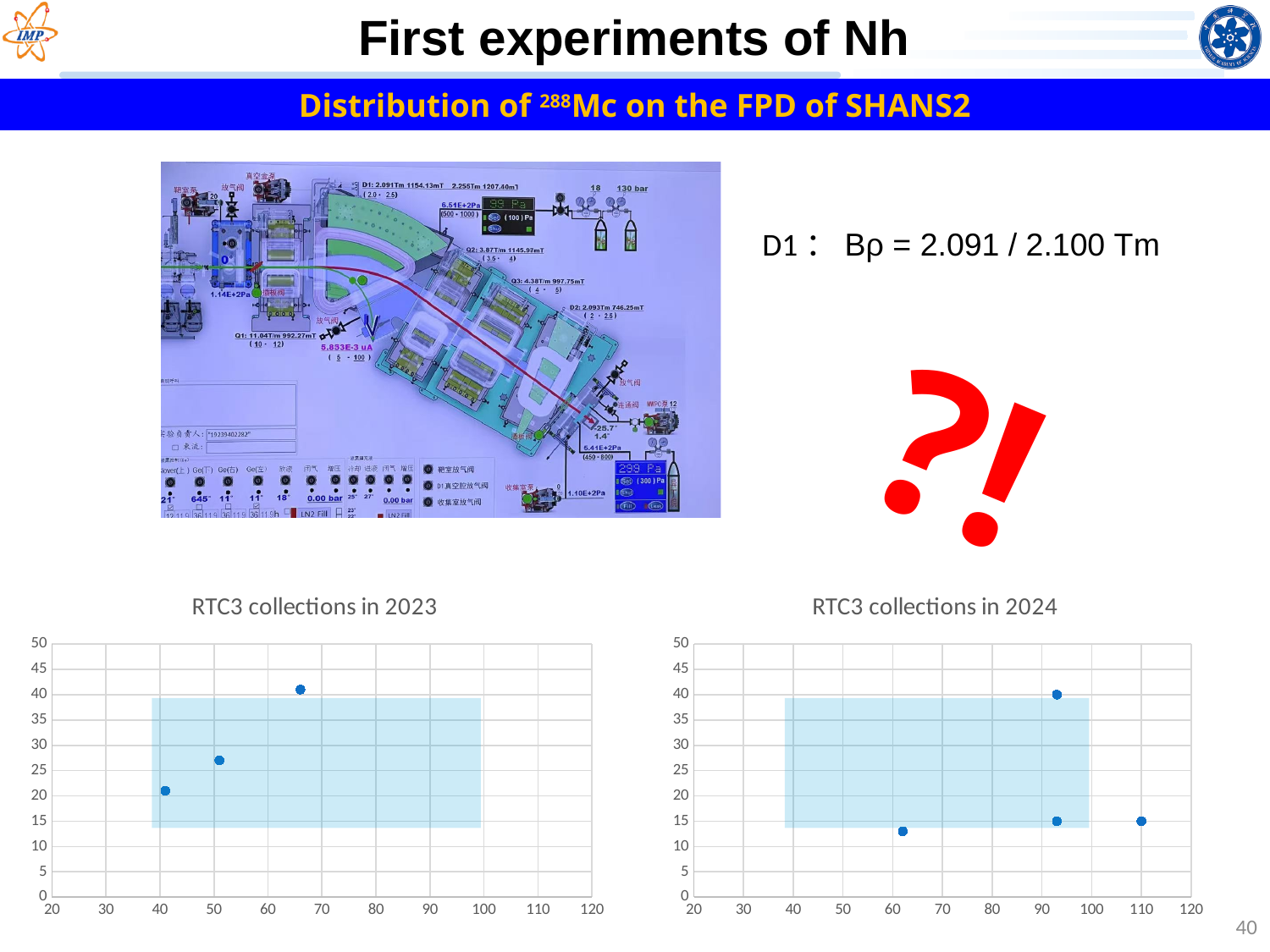
How many data points are plotted in the "RTC3 collections in 2023" chart? 3 In the "RTC3 collections in 2023" chart, is the y value of the highest point greater or less than 40? greater How many data points are plotted in the "RTC3 collections in 2024" chart? 4 In the "RTC3 collections in 2024" chart, is the x value of the rightmost point greater or less than 100? greater In the "RTC3 collections in 2024" chart, is the y value of the highest point greater or less than 35? greater What kind of chart is "RTC3 collections in 2023"? scatter chart Which chart has more plotted points, "RTC3 collections in 2023" or "RTC3 collections in 2024"? RTC3 collections in 2024 What is the maximum value shown on the y axis of the "RTC3 collections in 2024" chart? 50 What is the title of the chart on the bottom left of the slide? RTC3 collections in 2023 In the "RTC3 collections in 2023" chart, do the y values rise or fall as the x values increase? rise